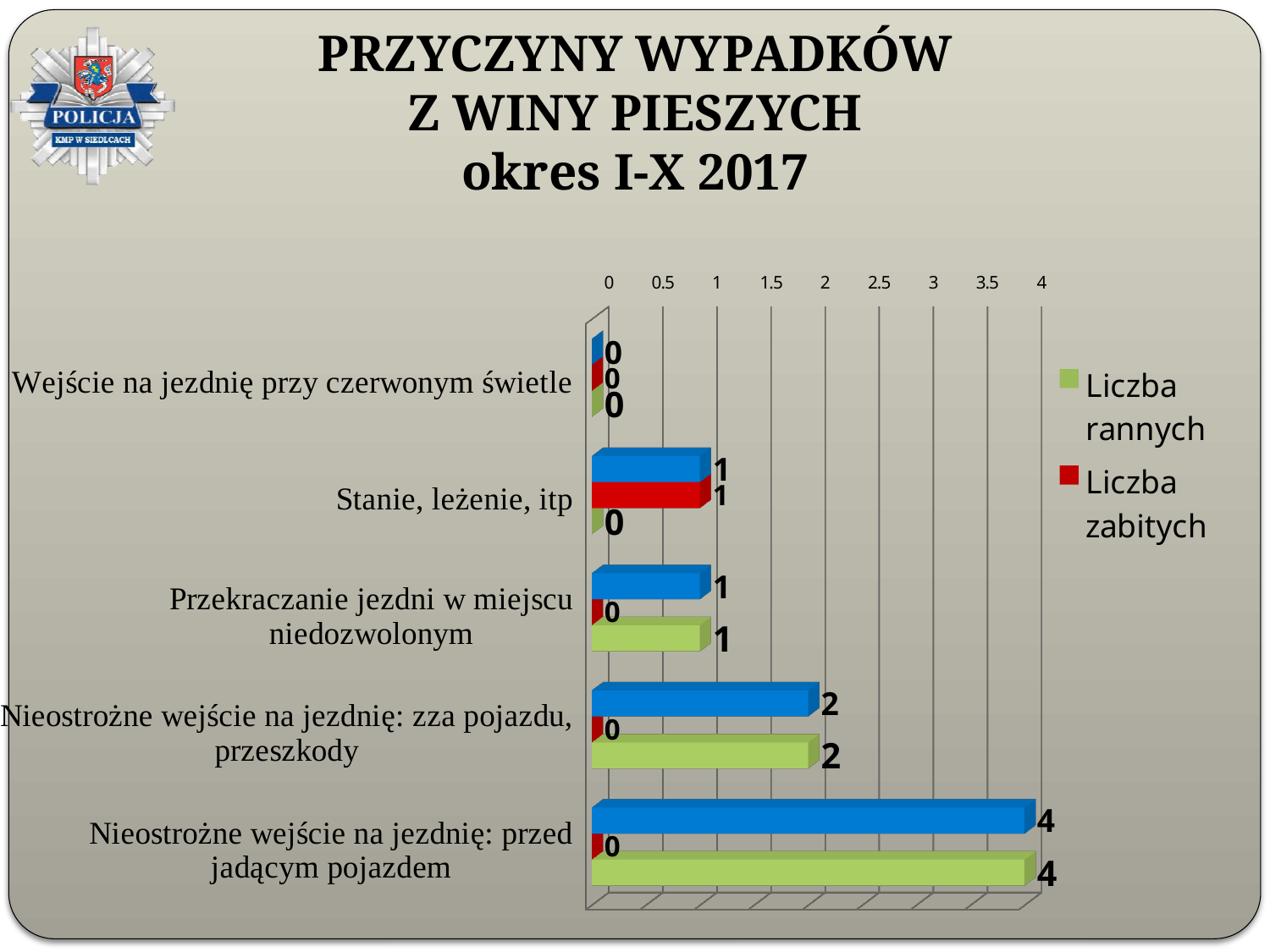
How many series does the legend list? 2 Which category has the highest value of Liczba zabitych? Stanie, leżenie, itp What is the difference in Liczba rannych between "Nieostrożne wejście na jezdnię: przed jadącym pojazdem" and "Nieostrożne wejście na jezdnię: zza pojazdu, przeszkody"? 2 What is the value of Liczba zabitych for "Wejście na jezdnię przy czerwonym świetle"? 0 Which has the larger value of Liczba rannych: "Stanie, leżenie, itp" or "Przekraczanie jezdni w miejscu niedozwolonym"? Przekraczanie jezdni w miejscu niedozwolonym What is the value of Liczba rannych for "Nieostrożne wejście na jezdnię: przed jadącym pojazdem"? 4 What is the value of Liczba zabitych for "Stanie, leżenie, itp"? 1 Which category has the highest value of Liczba rannych? Nieostrożne wejście na jezdnię: przed jadącym pojazdem What is the value of Liczba rannych for "Nieostrożne wejście na jezdnię: zza pojazdu, przeszkody"? 2 What kind of chart is shown on the slide? bar chart What is the value of Liczba rannych for "Przekraczanie jezdni w miejscu niedozwolonym"? 1 How many categories are shown on the chart? 5